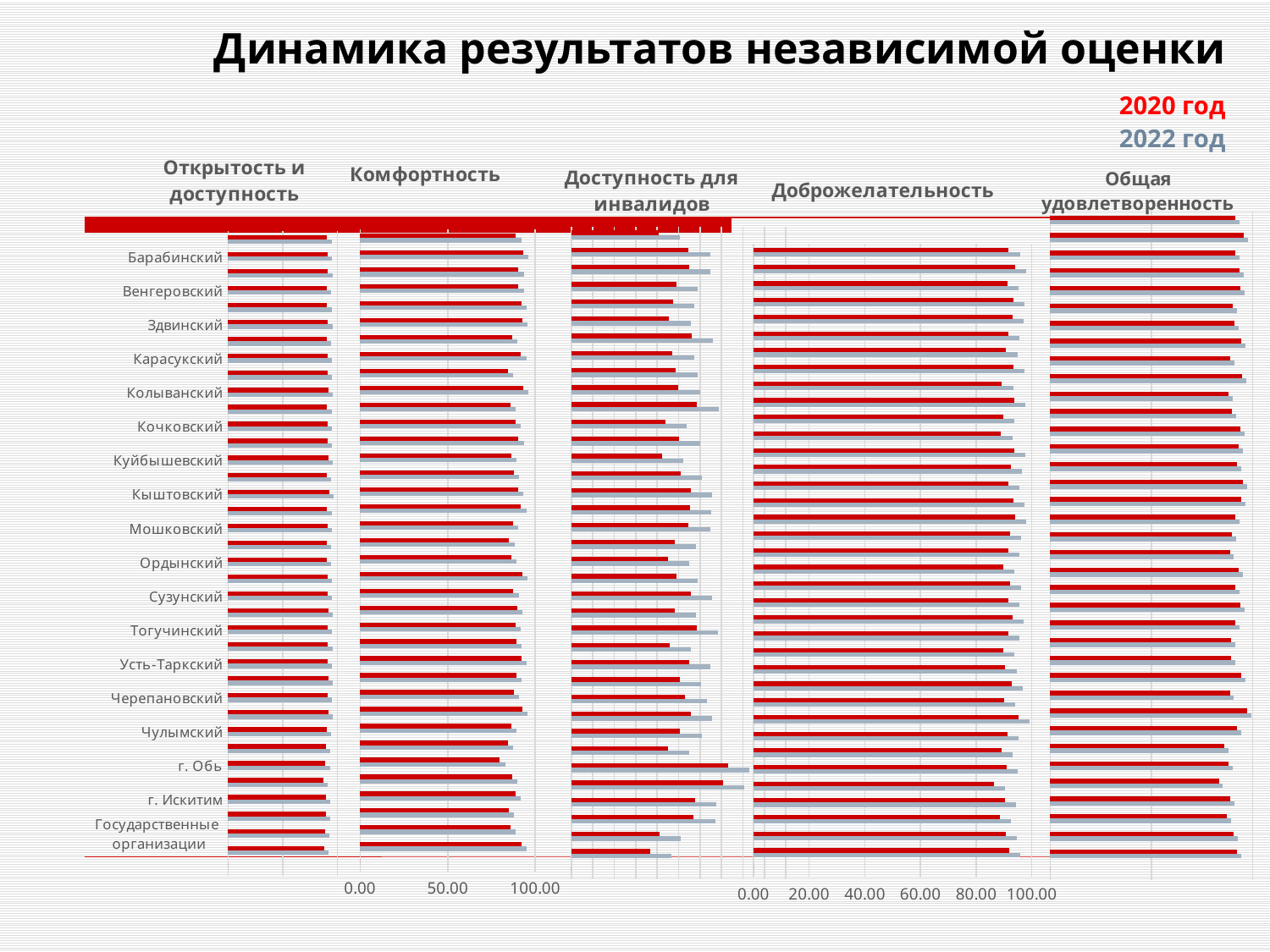
In the "Доброжелательность" chart, is the 2020 value for Барабинский greater or less than 80.00? greater In the "Доброжелательность" chart, is the 2020 value for Кочковский greater or less than 100.00? less In the "Комфортность" chart, is the 2020 value for г. Искитим greater or less than 100.00? less What kind of chart is used for the "Доброжелательность" panel? bar chart Which colour represents 2020 год in the charts? red Which two years are compared in the legend? 2020 год and 2022 год How many series does the legend list? 2